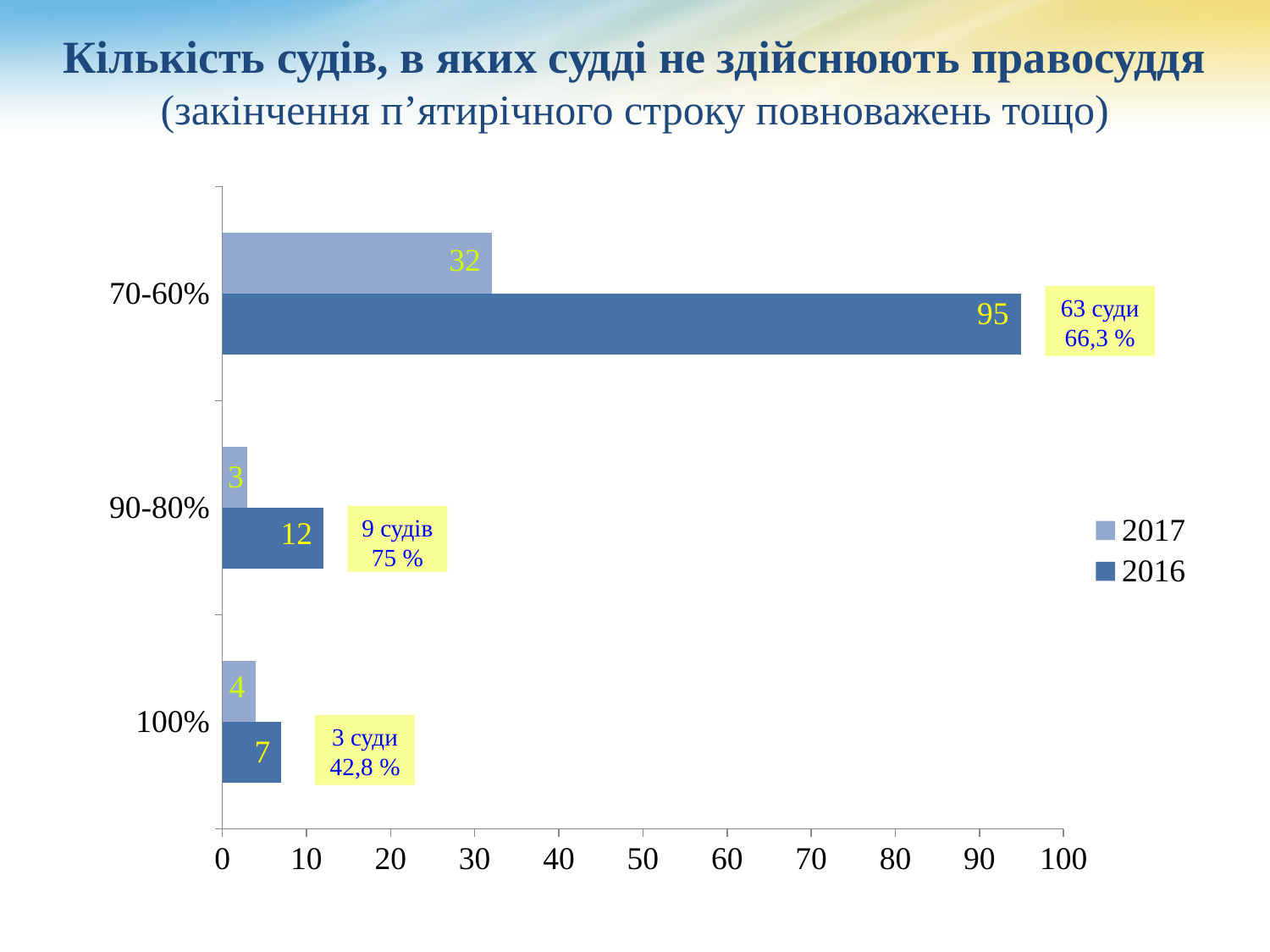
How many categories are shown on the y axis? 3 What is the difference between the 2016 and 2017 values in the 70-60% category? 63 What is the value for 2016 in the 70-60% category? 95 How many series does the legend list? 2 What is the value for 2017 in the 70-60% category? 32 Which category has the lowest value for the 2017 series? 90-80% What is the value for 2017 in the 100% category? 4 What percentage is shown in the annotation box next to the 90-80% bars? 75 % Which category has the highest value for the 2016 series? 70-60% What kind of chart is shown on the slide? bar chart Which is larger in the 100% category: the 2016 value or the 2017 value? 2016 What is the value for 2016 in the 90-80% category? 12